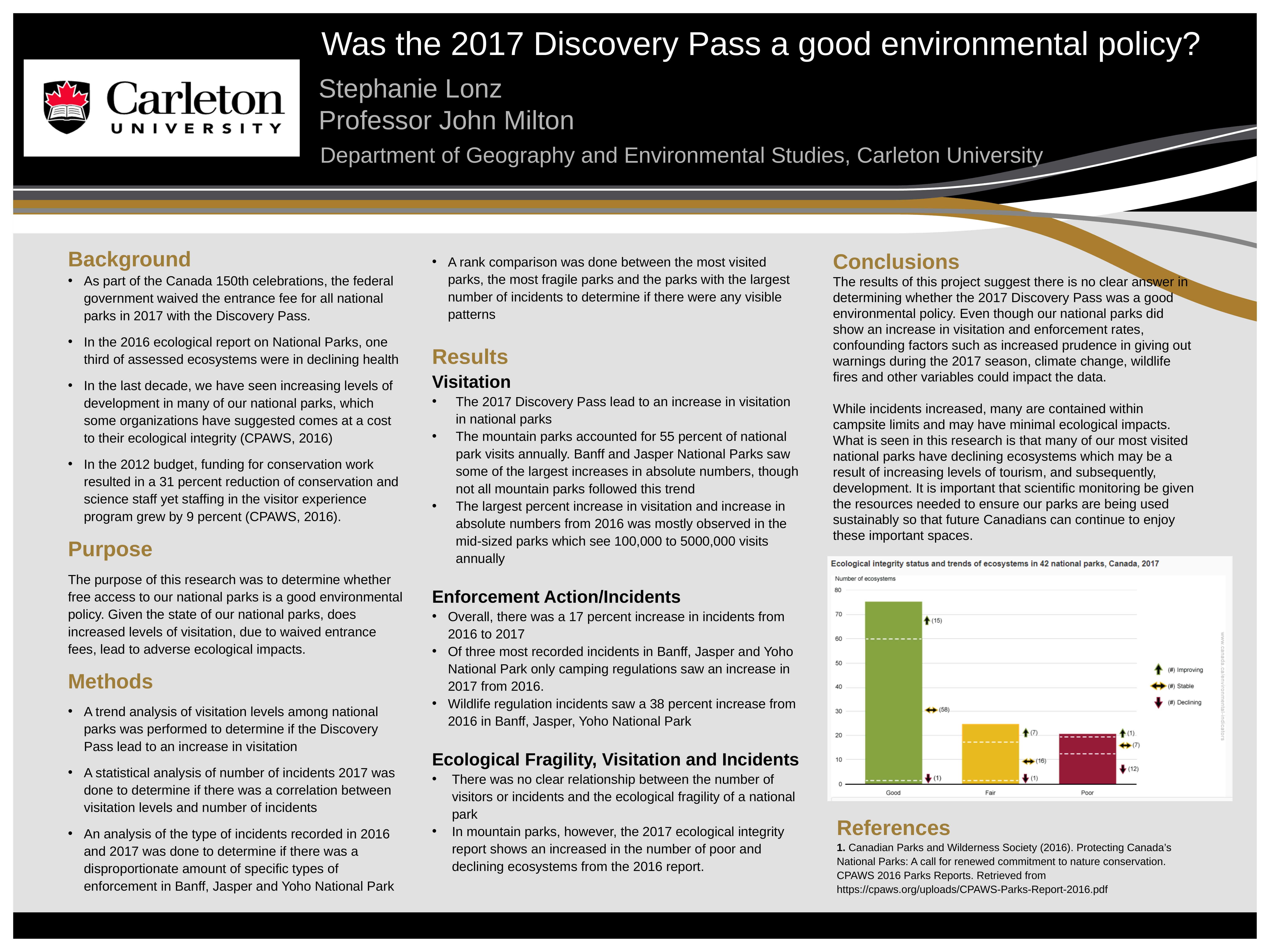
How many ecosystems in the Fair category are labelled as improving? 7 Which category has the shortest bar in the chart? Poor What is the difference between the number of stable ecosystems in the Good category and in the Fair category? 42 Is the value for the Poor bar greater or less than 30? less What kind of chart is shown on the slide? bar chart Which has more improving ecosystems, the Good category or the Poor category? Good Which category has the tallest bar in the chart? Good How many categories are shown on the x axis of the chart? 3 How many ecosystems in the Good category are labelled as stable? 58 How many ecosystems in the Poor category are labelled as declining? 12 How many entries does the chart's legend list? 3 Is the value for the Good bar greater or less than 70? greater